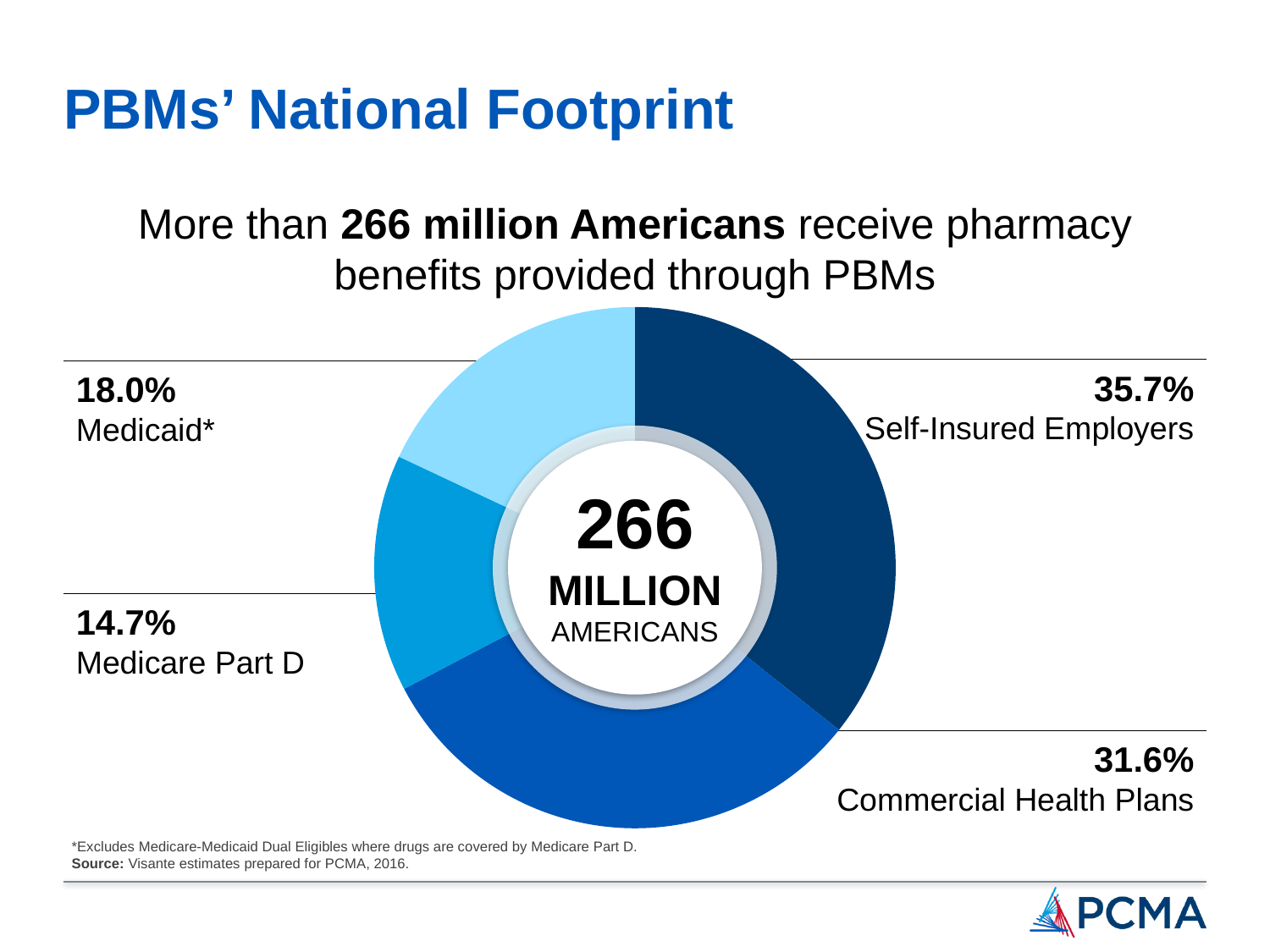
Which category has the smallest share of the chart? Medicare Part D How many categories are shown in the donut chart? 4 What percentage is shown for Commercial Health Plans? 31.6% What share of the donut chart is Self-Insured Employers? 35.7% What percentage is shown for Medicare Part D? 14.7% What percentage is shown for Medicaid*? 18.0% What type of chart is shown on the slide? Donut (pie) chart What is the difference in percentage points between Medicaid* and Medicare Part D? 3.3 What number is printed in the center of the donut chart? 266 MILLION AMERICANS Which category has the largest share of the chart? Self-Insured Employers Which is larger, the share for Medicaid* or the share for Medicare Part D? Medicaid* What is the difference in percentage points between Self-Insured Employers and Commercial Health Plans? 4.1